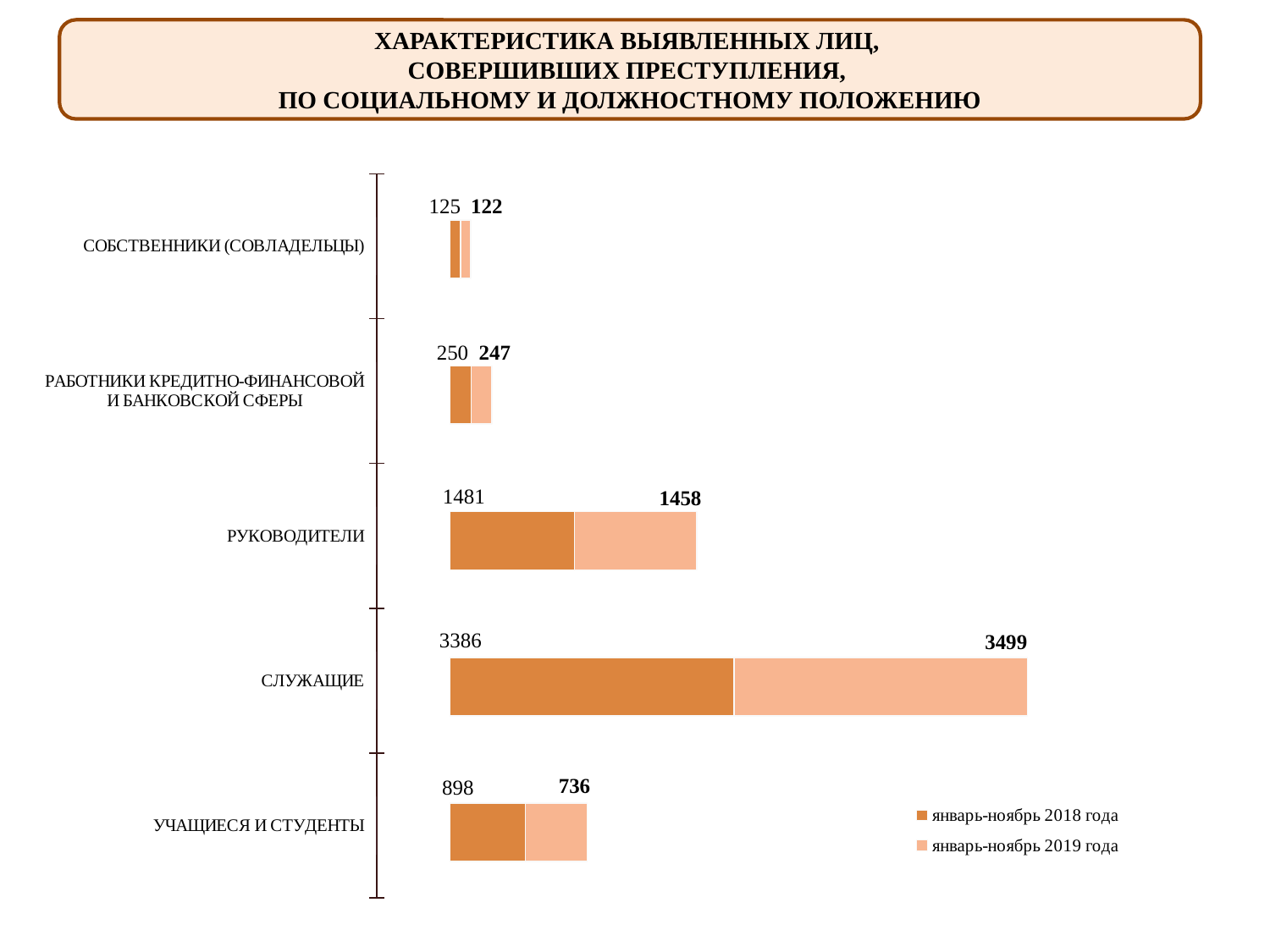
How many categories are shown on the chart? 5 How many series does the legend list? 2 What is the value for УЧАЩИЕСЯ И СТУДЕНТЫ in январь-ноябрь 2019 года? 736 Which category has the highest value in январь-ноябрь 2018 года? СЛУЖАЩИЕ What is the value for СЛУЖАЩИЕ in январь-ноябрь 2019 года? 3499 For РУКОВОДИТЕЛИ, which is larger: the value for январь-ноябрь 2018 года or январь-ноябрь 2019 года? январь-ноябрь 2018 года Which category has the lowest value in январь-ноябрь 2019 года? СОБСТВЕННИКИ (СОВЛАДЕЛЬЦЫ) What is the difference between the 2019 and 2018 values for СЛУЖАЩИЕ? 113 What is the total of the stacked bar for РАБОТНИКИ КРЕДИТНО-ФИНАНСОВОЙ И БАНКОВСКОЙ СФЕРЫ? 497 What is the value for РУКОВОДИТЕЛИ in январь-ноябрь 2018 года? 1481 What is the value for СОБСТВЕННИКИ (СОВЛАДЕЛЬЦЫ) in январь-ноябрь 2018 года? 125 What is the difference between the 2018 and 2019 values for УЧАЩИЕСЯ И СТУДЕНТЫ? 162